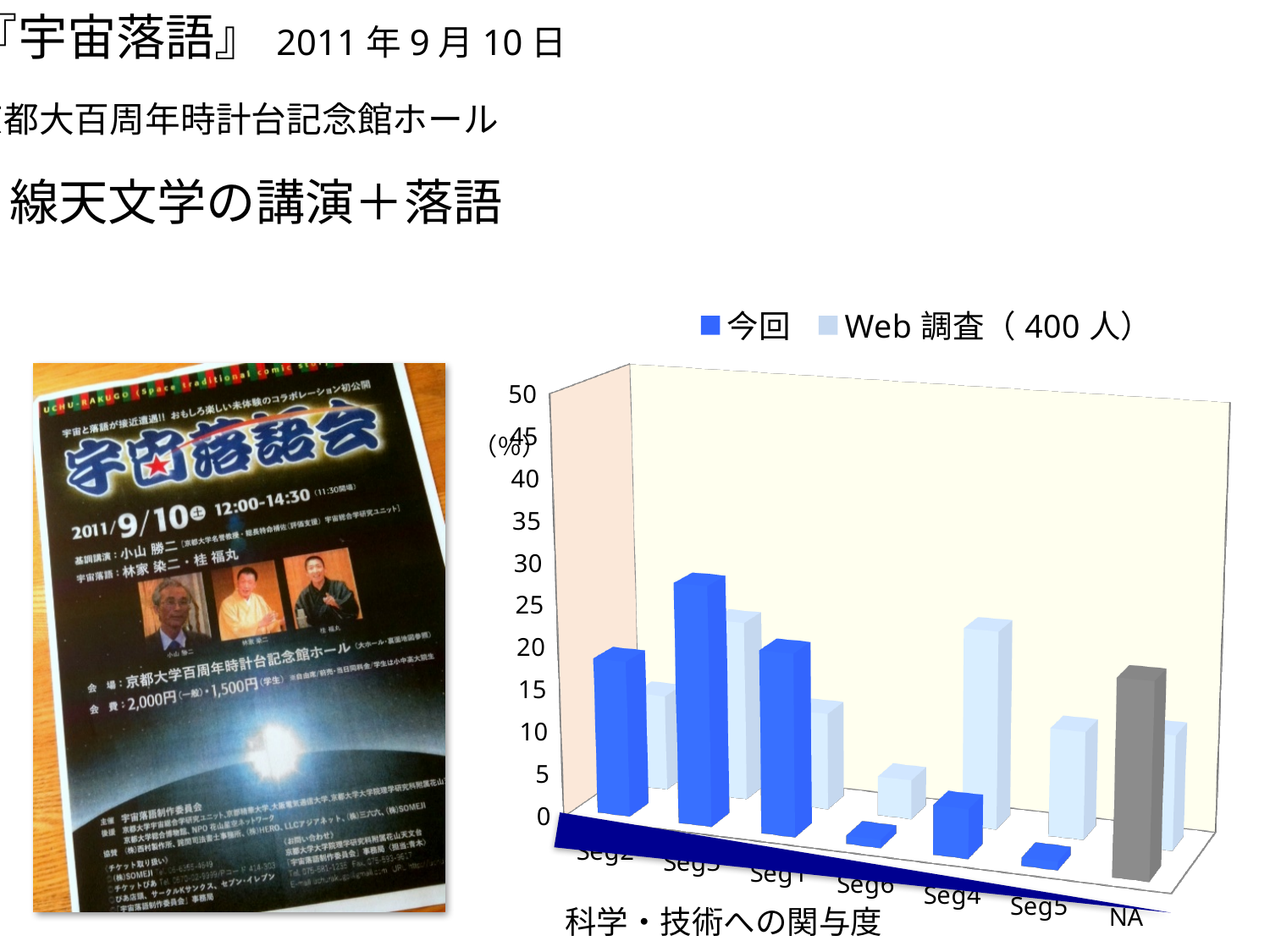
Is the 今回 value for Seg5 greater or less than 5? less For Seg4, which series has the larger value, 今回 or Web 調査（400人）? Web 調査（400人） Is the 今回 value for Seg3 greater or less than 20? greater Is the Web 調査（400人） value for Seg4 greater or less than 15? greater What kind of chart is shown on the slide? bar chart What is the x-axis title of the chart? 科学・技術への関与度 Which category has the lowest value for the Web 調査（400人） series? Seg6 Which is larger for the 今回 series, Seg3 or Seg4? Seg3 How many series does the chart legend list? 2 How many categories are shown along the x axis of the chart? 7 Which category has the highest value for the 今回 series? Seg3